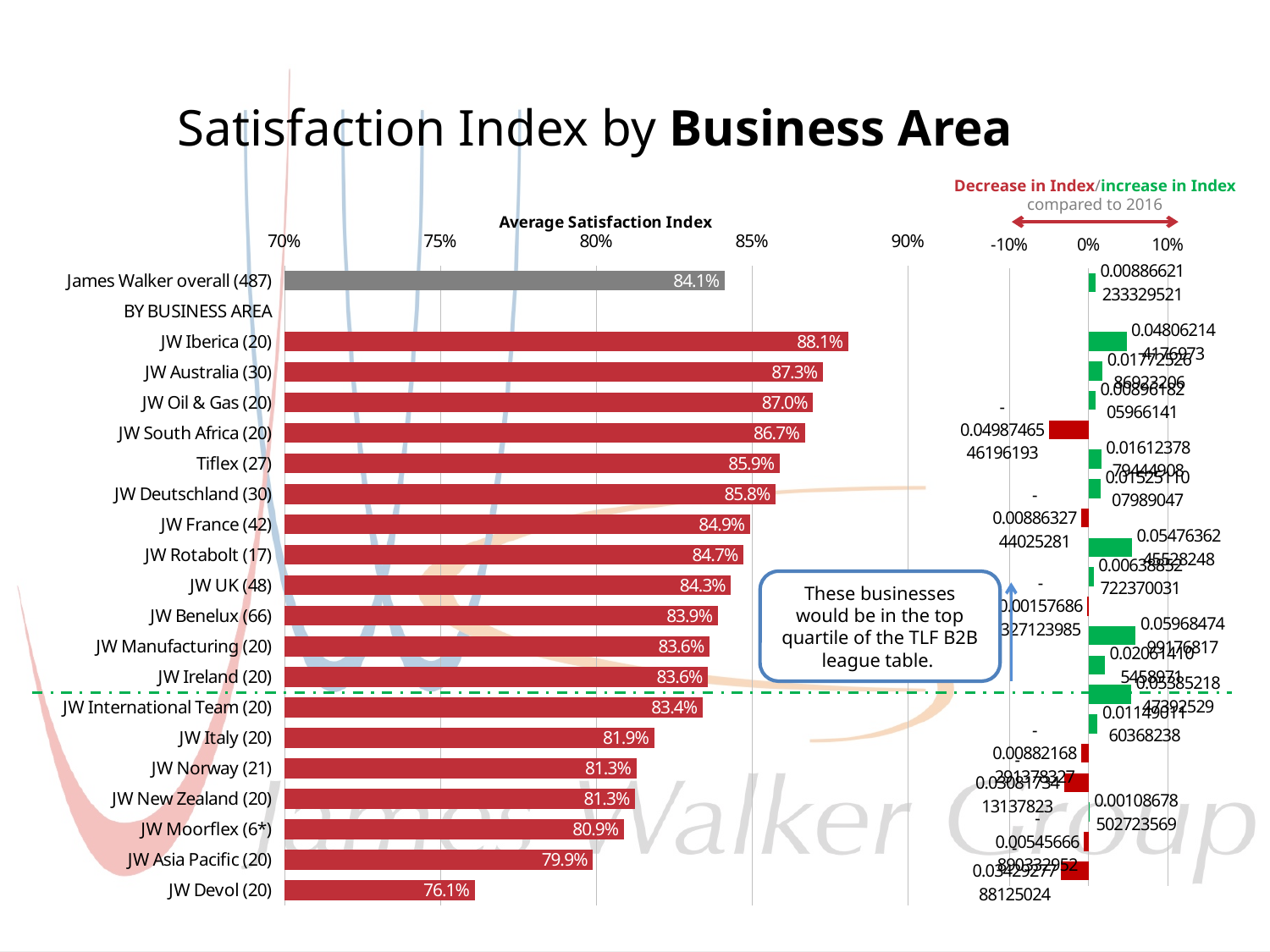
On the Average Satisfaction Index chart, what is the value for JW Devol (20)? 76.1% On the Average Satisfaction Index chart, what is the value for James Walker overall (487)? 84.1% On the Average Satisfaction Index chart, which is larger, the value for JW Australia (30) or the value for JW France (42)? JW Australia (30) On the Average Satisfaction Index chart, is the value for JW Asia Pacific (20) greater or less than 80%? less On the Average Satisfaction Index chart, what is the value for Tiflex (27)? 85.9% On the Average Satisfaction Index chart, what is the difference between JW Manufacturing (20) and JW Ireland (20)? 0.0% On the Average Satisfaction Index chart, how many business areas are listed under BY BUSINESS AREA? 19 On the Average Satisfaction Index chart, which business area has the lowest satisfaction index? JW Devol (20) On the Average Satisfaction Index chart, what is the difference between JW Iberica (20) and JW Devol (20)? 12.0% What kind of chart is the Average Satisfaction Index chart? bar chart On the Average Satisfaction Index chart, what is the value for JW Iberica (20)? 88.1% On the Average Satisfaction Index chart, which business area has the highest satisfaction index? JW Iberica (20)